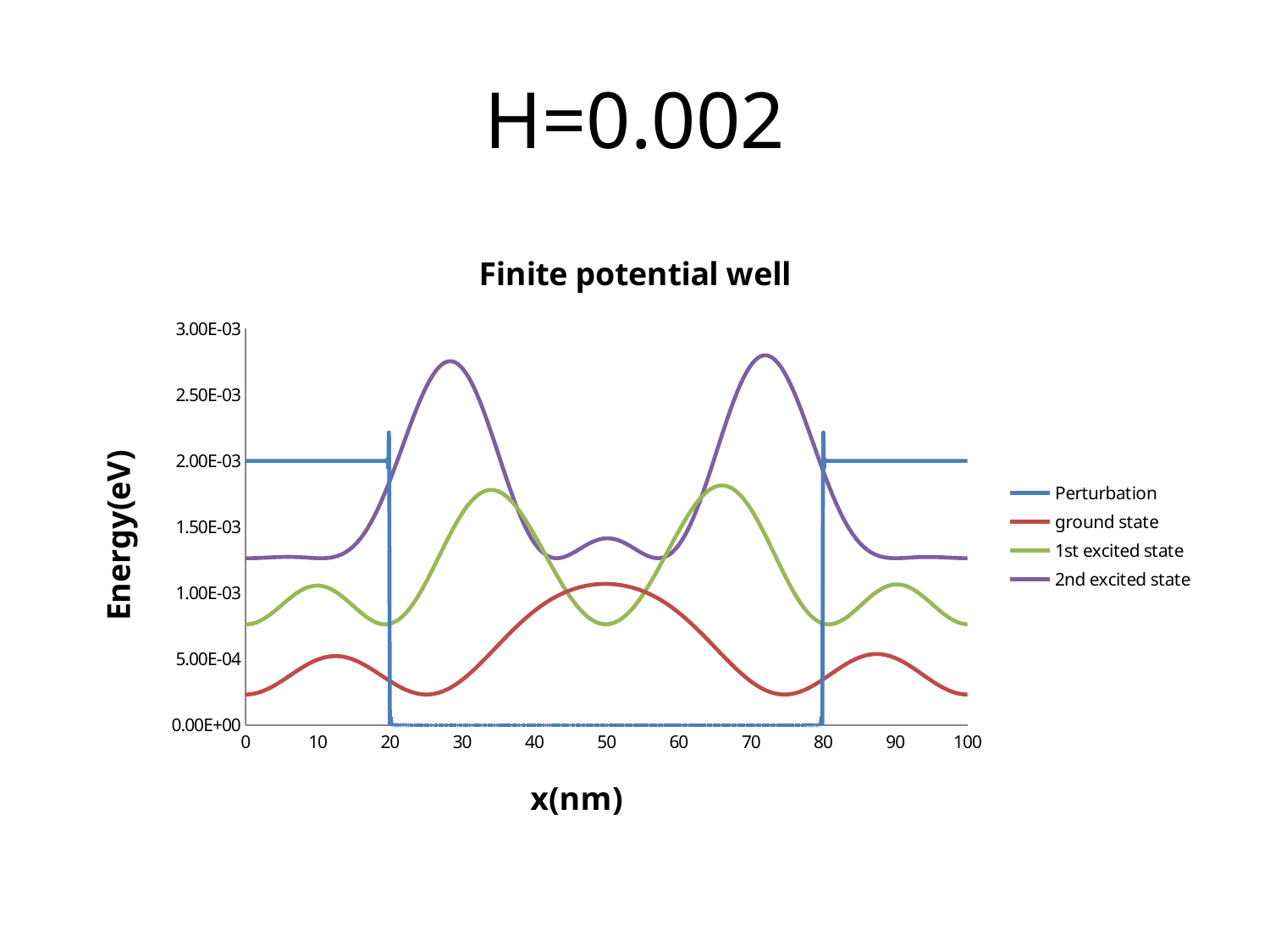
What is the value of the Perturbation series at x = 10? 2.00E-03 What is the label of the vertical axis of the chart? Energy(eV) What is the title of the chart? Finite potential well Is the value of the 2nd excited state at x = 30 greater or less than 2.50E-03? greater How many series does the legend of the chart list? 4 What is the value of the Perturbation series at x = 50? 0.00E+00 Which series reaches the highest value anywhere on the chart? 2nd excited state At x = 50, which is higher: the ground state or the 1st excited state? ground state What kind of chart is shown on the slide? line chart Is the value of the 1st excited state at x = 50 greater or less than 1.00E-03? less At x = 30, which is higher: the 1st excited state or the 2nd excited state? 2nd excited state Is the value of the ground state at x = 0 greater or less than 5.00E-04? less